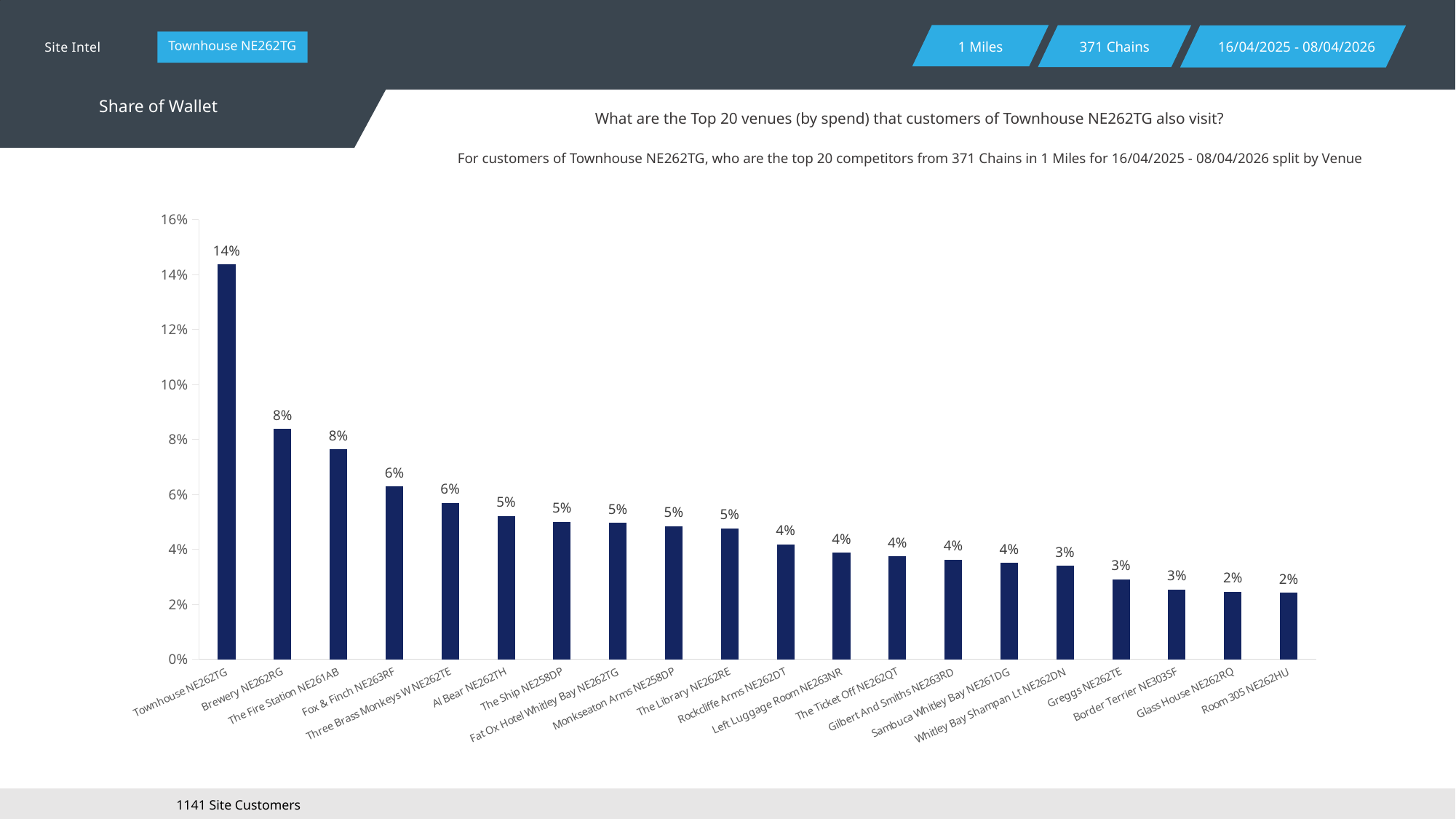
What is the value for Rockcliffe Arms NE262DT? 4% What is the value for Fox & Finch NE263RF? 6% Is the value for Townhouse NE262TG greater or less than 12%? greater How many venues are shown on the chart? 20 What is the value for Townhouse NE262TG? 14% What is the difference between the values for Townhouse NE262TG and Brewery NE262RG? 6% What is the value for Greggs NE262TE? 3% What kind of chart is shown on the slide? bar chart Which is larger, the value for Townhouse NE262TG or the value for Fox & Finch NE263RF? Townhouse NE262TG Which venue has the highest share of wallet? Townhouse NE262TG Do the values rise or fall from left to right along the x axis? fall Is the value for Al Bear NE262TH greater or less than 6%? less